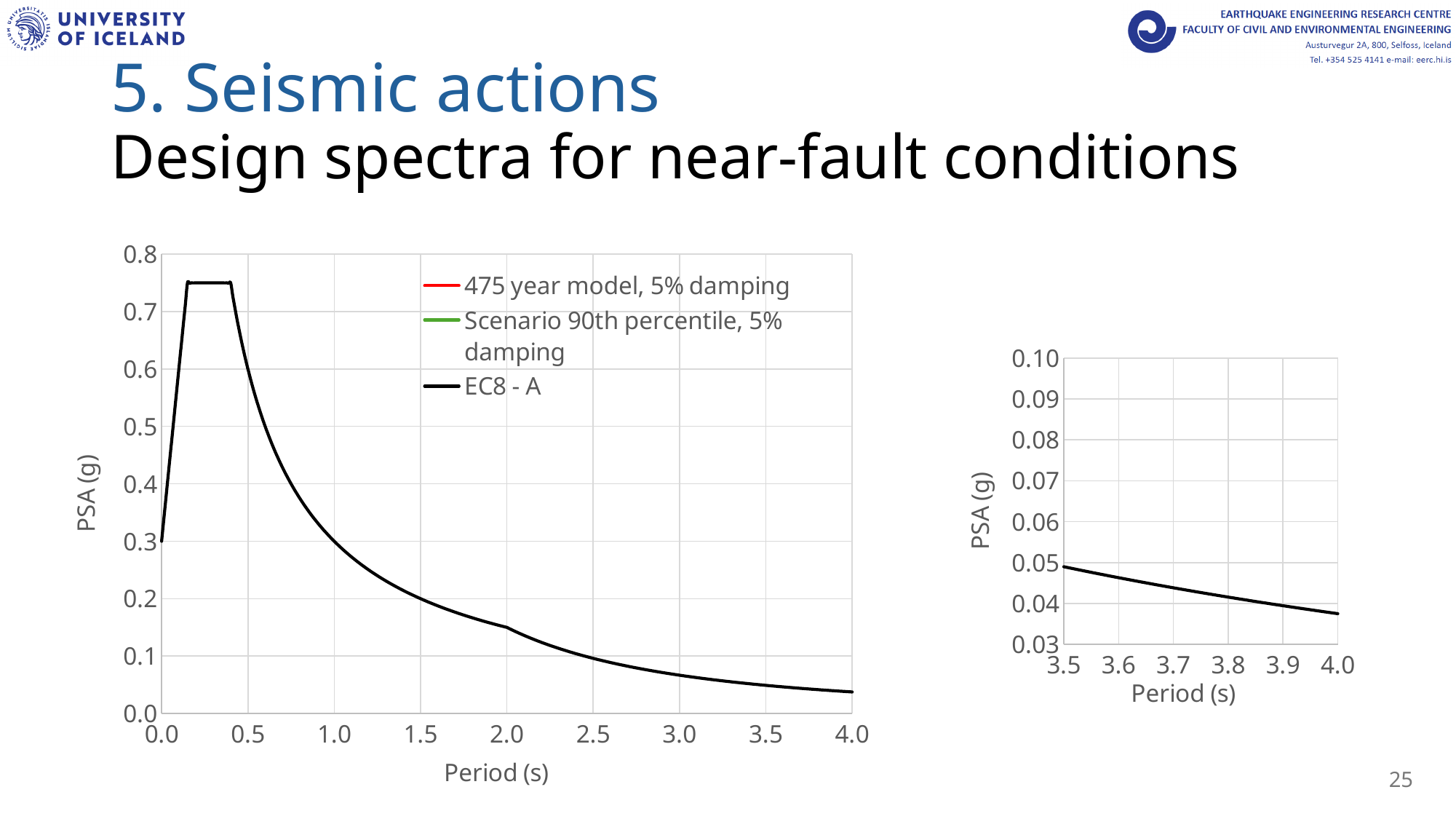
On the left chart, is the peak value of the EC8 - A line greater or less than 0.7? greater On the right chart, is the value at a period of 3.5 s greater or less than 0.04? greater What is the label of the y axis on the left chart? PSA (g) On the left chart, what is the PSA value of the EC8 - A line at a period of 0.0 s? 0.3 On the left chart, does the EC8 - A line rise or fall as the period increases from 1.0 s to 4.0 s? fall What kind of chart is the right chart on the slide? line chart On the left chart, is the value of the EC8 - A line at a period of 2.0 s greater or less than 0.2? less What is the label of the x axis on the left chart? Period (s) How many series does the legend of the left chart list? 3 What kind of chart is the left chart on the slide? line chart On the right chart, does the line rise or fall as the period increases from 3.5 s to 4.0 s? fall